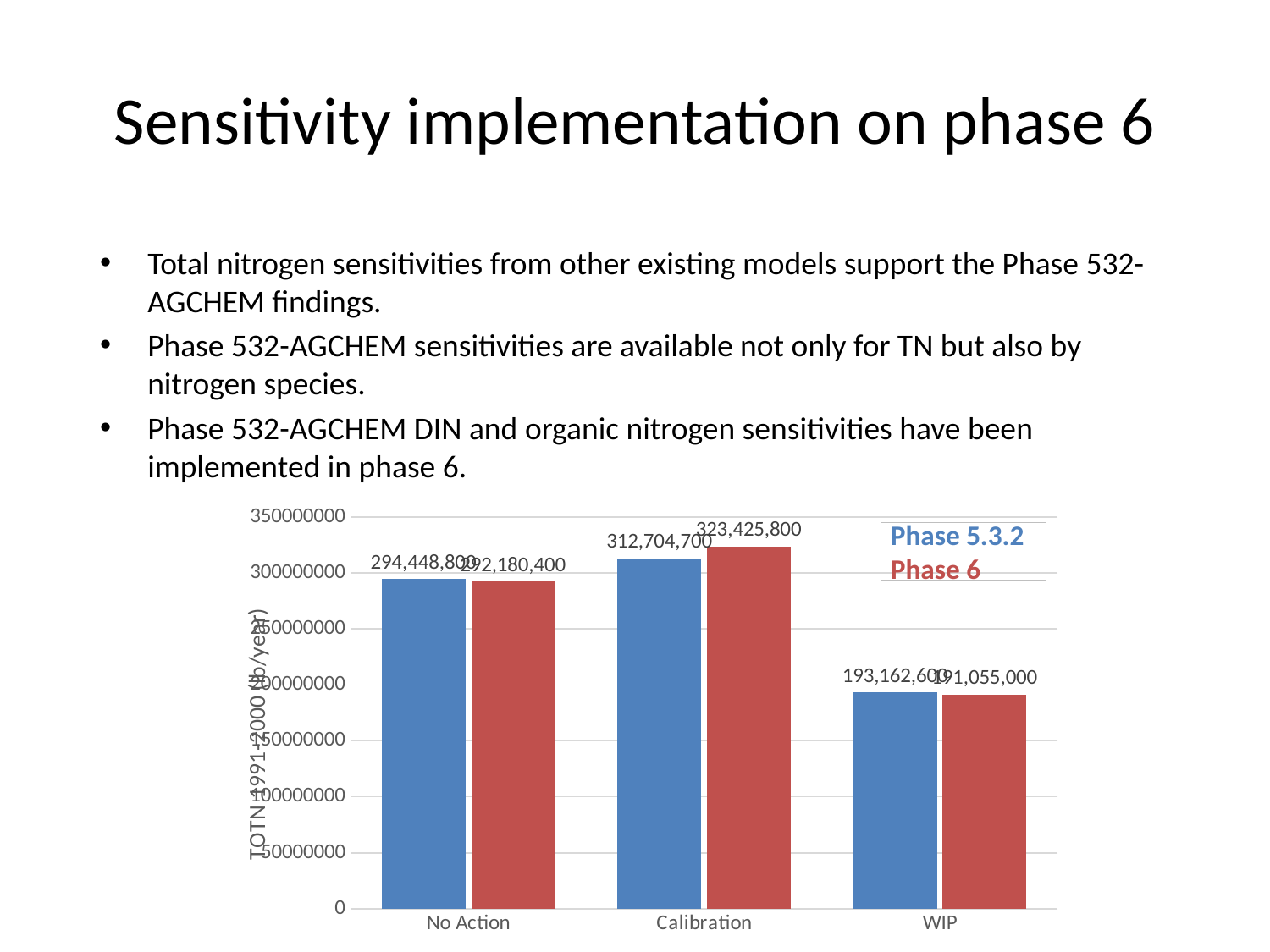
What is the Phase 6 value for Calibration? 323,425,800 Which category has the lowest Phase 5.3.2 value? WIP For WIP, which is larger: the Phase 5.3.2 value or the Phase 6 value? Phase 5.3.2 What is the Phase 5.3.2 value for No Action? 294,448,800 What is the difference between the Phase 6 and Phase 5.3.2 values for Calibration? 10,721,100 How many categories are shown on the x axis? 3 What is the Phase 6 value for WIP? 191,055,000 How many series does the legend list? 2 What is the Phase 5.3.2 value for Calibration? 312,704,700 What kind of chart is shown on the slide? bar chart Which category has the highest Phase 6 value? Calibration Is the Phase 6 value for WIP greater or less than 200000000? less